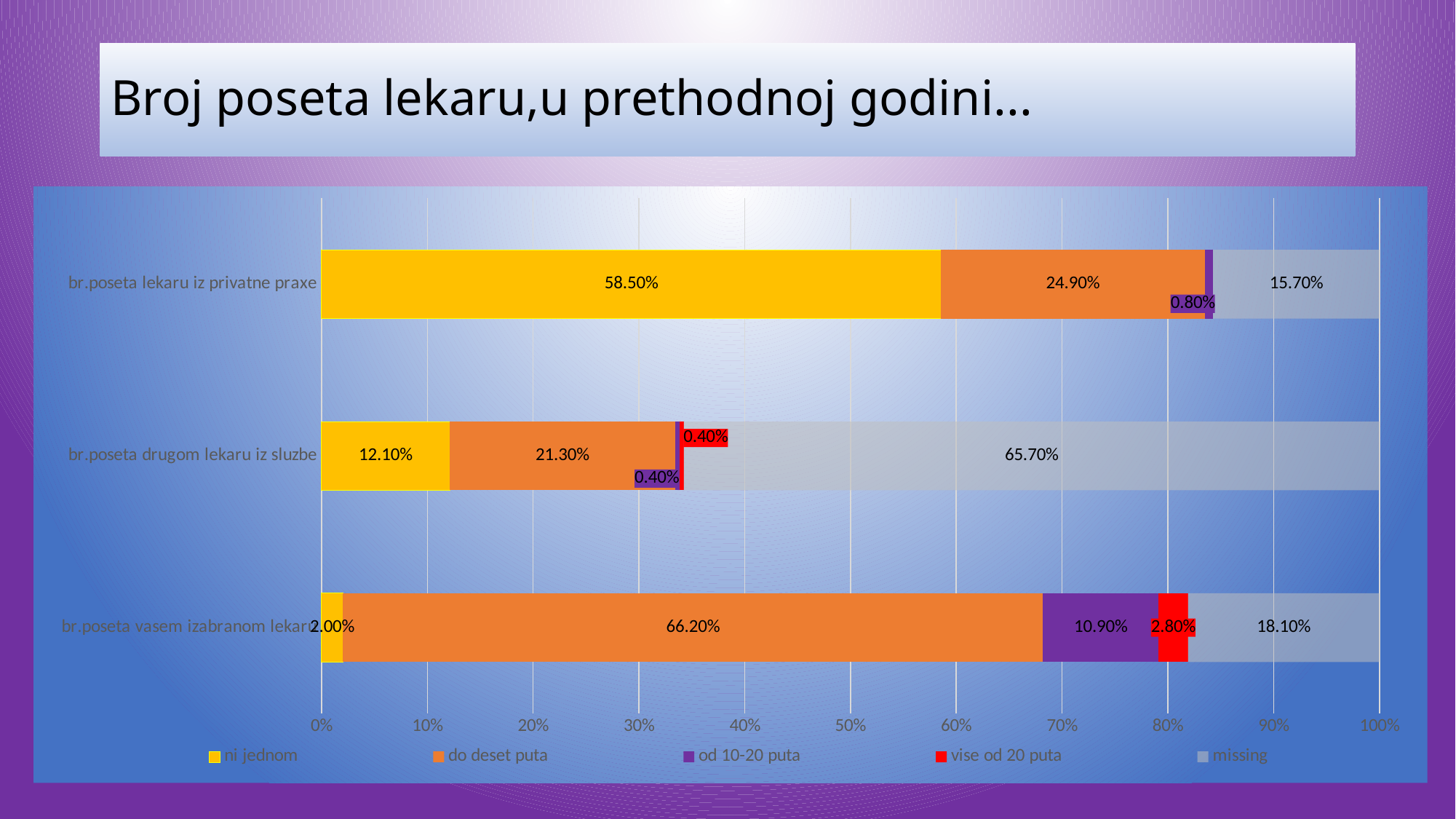
Which category has the lowest 'ni jednom' value? br.poseta vasem izabranom lekaru What is the difference between the 'do deset puta' values for 'br.poseta vasem izabranom lekaru' and 'br.poseta lekaru iz privatne praxe'? 41.30% Which category has the highest 'missing' value? br.poseta drugom lekaru iz sluzbe What is the 'do deset puta' value for 'br.poseta vasem izabranom lekaru'? 66.20% What is the 'ni jednom' value for 'br.poseta lekaru iz privatne praxe'? 58.50% How many categories are plotted on the chart? 3 Which is larger: the 'vise od 20 puta' value for 'br.poseta vasem izabranom lekaru' or for 'br.poseta drugom lekaru iz sluzbe'? br.poseta vasem izabranom lekaru What is the title of the slide? Broj poseta lekaru,u prethodnoj godini... What is the 'missing' value for 'br.poseta drugom lekaru iz sluzbe'? 65.70% How many series does the legend list? 5 What is the 'od 10-20 puta' value for 'br.poseta vasem izabranom lekaru'? 10.90% What kind of chart is shown on the slide? stacked bar chart